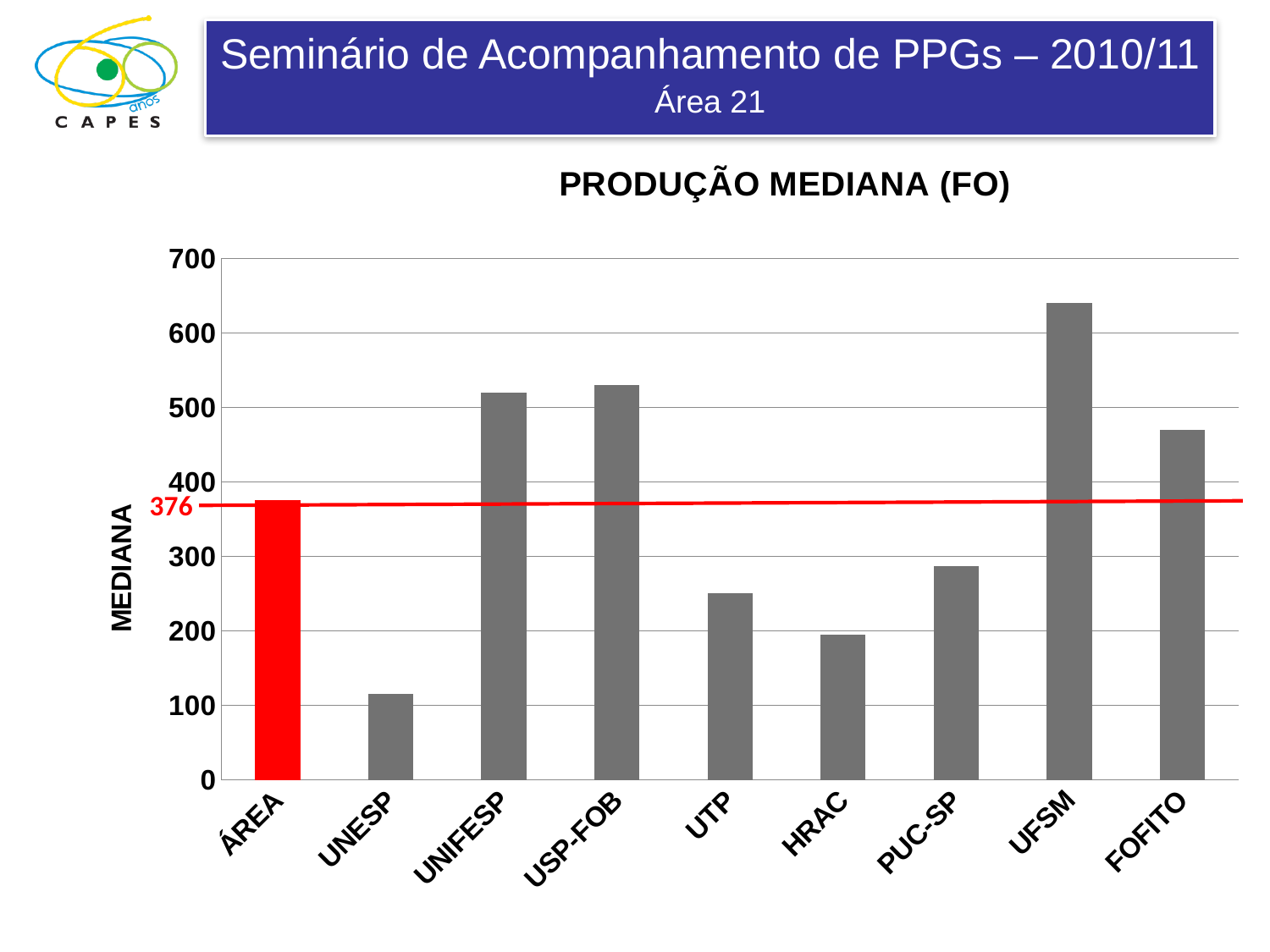
Which is larger, the value for UTP or the value for HRAC? UTP Which category has the highest value? UFSM Which category has the lowest value? UNESP Is the value for UFSM greater or less than 600? greater What is the value for ÁREA, as marked by the red line? 376 What type of chart is shown on the slide? Bar chart Is the value for UNESP greater or less than 200? less Is the value for PUC-SP greater or less than 300? less What is the title of the chart? PRODUÇÃO MEDIANA (FO) How many categories are shown on the x axis of the chart? 9 Which bar is coloured red in the chart? ÁREA